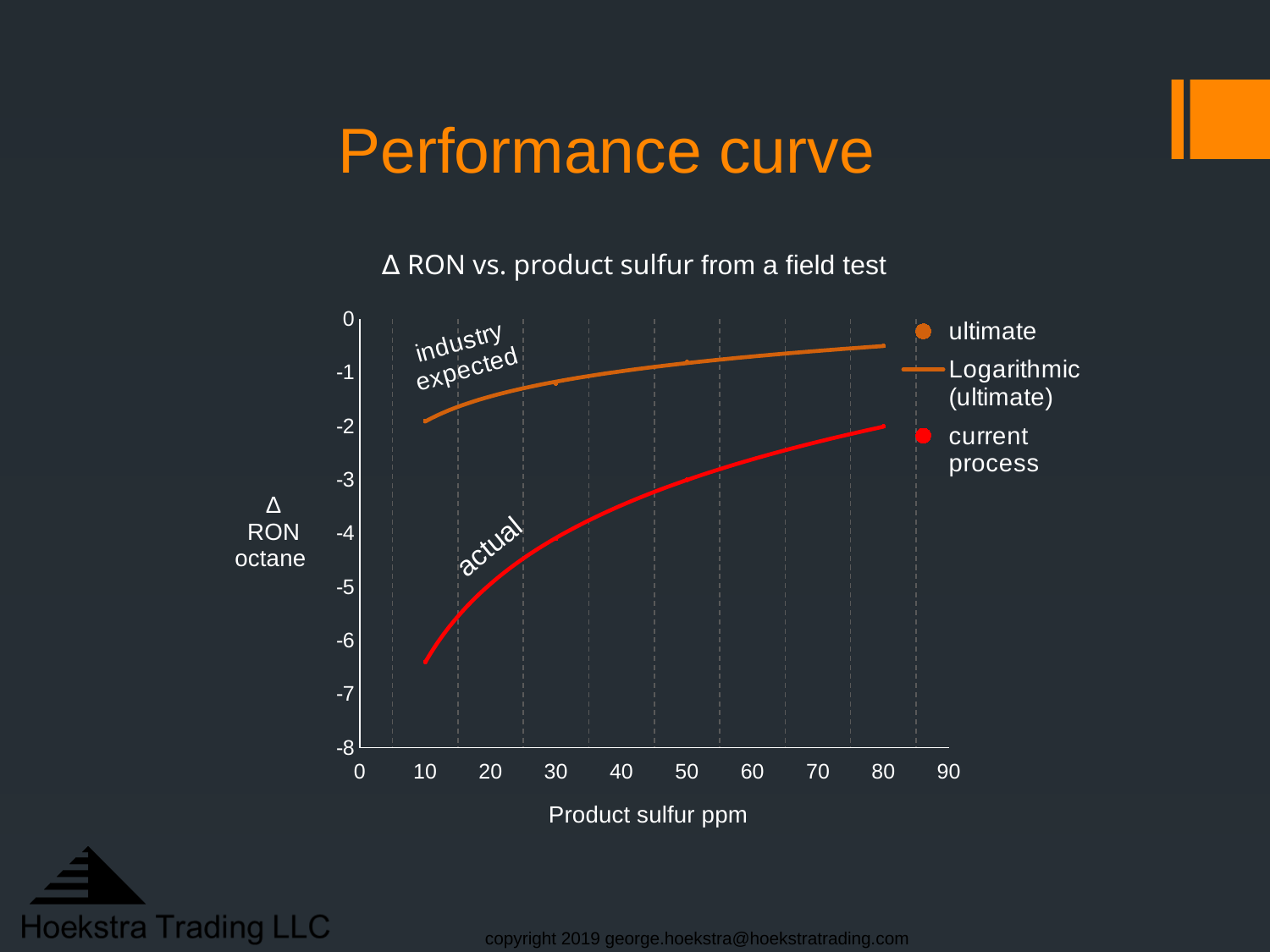
Which curve has the higher Δ RON at 10 ppm product sulfur, 'ultimate' or 'current process'? ultimate Which curve has the lower Δ RON at 80 ppm product sulfur, 'ultimate' or 'current process'? current process Is the value of the 'current process' curve at 10 ppm product sulfur greater or less than -6? less What is the title of the chart? Δ RON vs. product sulfur from a field test How many entries does the chart legend list? 3 Do the values of the 'current process' curve rise or fall as product sulfur increases? rise Is the value of the 'ultimate' curve at 10 ppm product sulfur greater or less than -3? greater Which curve is labelled 'actual' on the chart, the red one or the orange one? the red one What is the label of the x axis? Product sulfur ppm Is the value of the 'ultimate' curve at 80 ppm product sulfur greater or less than -1? greater Do the values of the 'ultimate' curve rise or fall as product sulfur increases? rise